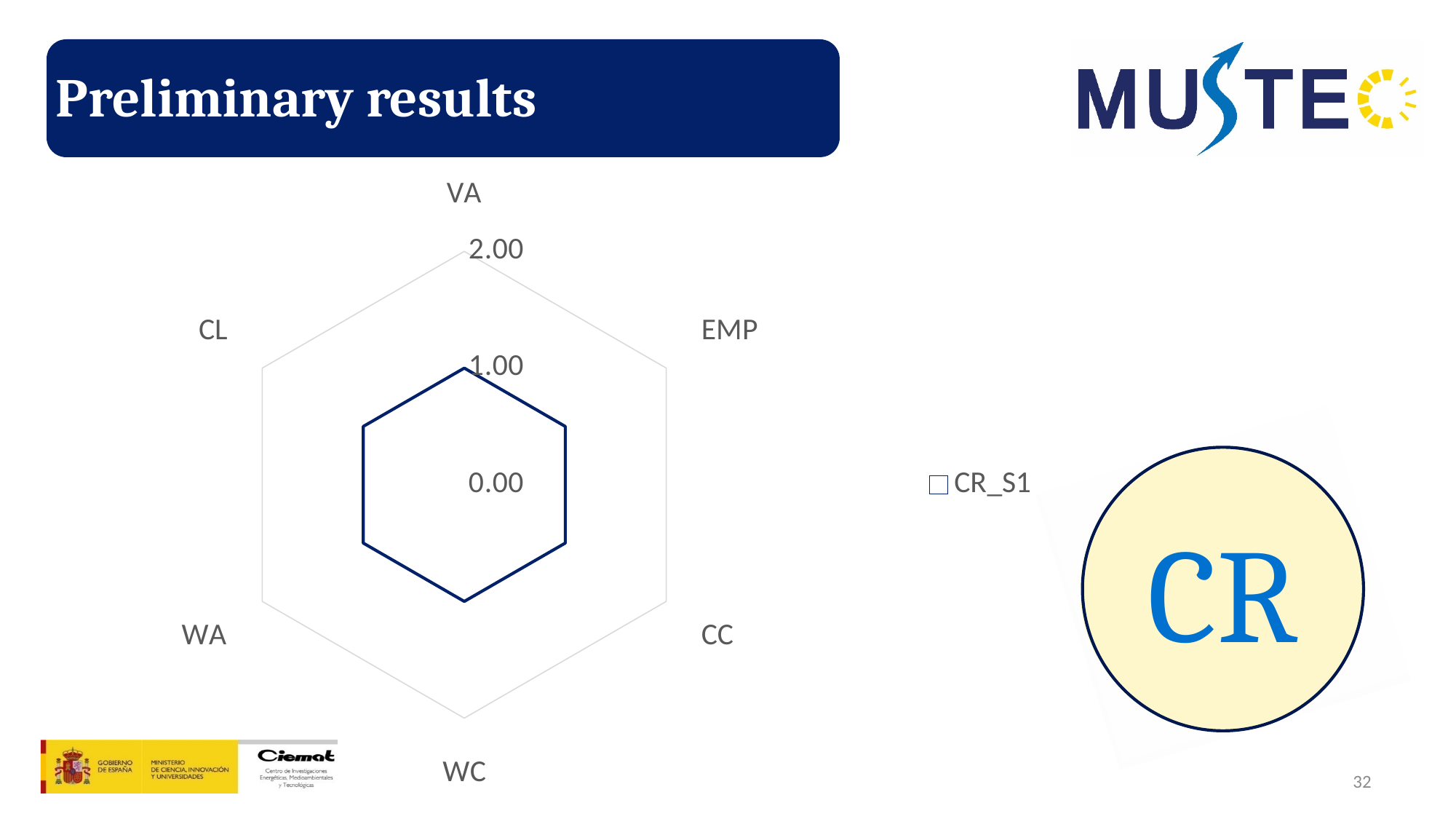
Which category is positioned at the bottom of the radar chart? WC What is the name of the series shown in the legend of the radar chart? CR_S1 Is the value for EMP in the CR_S1 series greater or less than 2.00? less Is the value for CC in the CR_S1 series greater or less than 0.00? greater How many series does the legend of the radar chart list? 1 Which category is positioned at the top of the radar chart? VA Is the value for WC in the CR_S1 series greater or less than 2.00? less What is the value for VA in the CR_S1 series? 1.00 What kind of chart is shown on the slide? radar chart What is the maximum value shown on the radar chart's axis scale? 2.00 How many categories (axes) does the radar chart have? 6